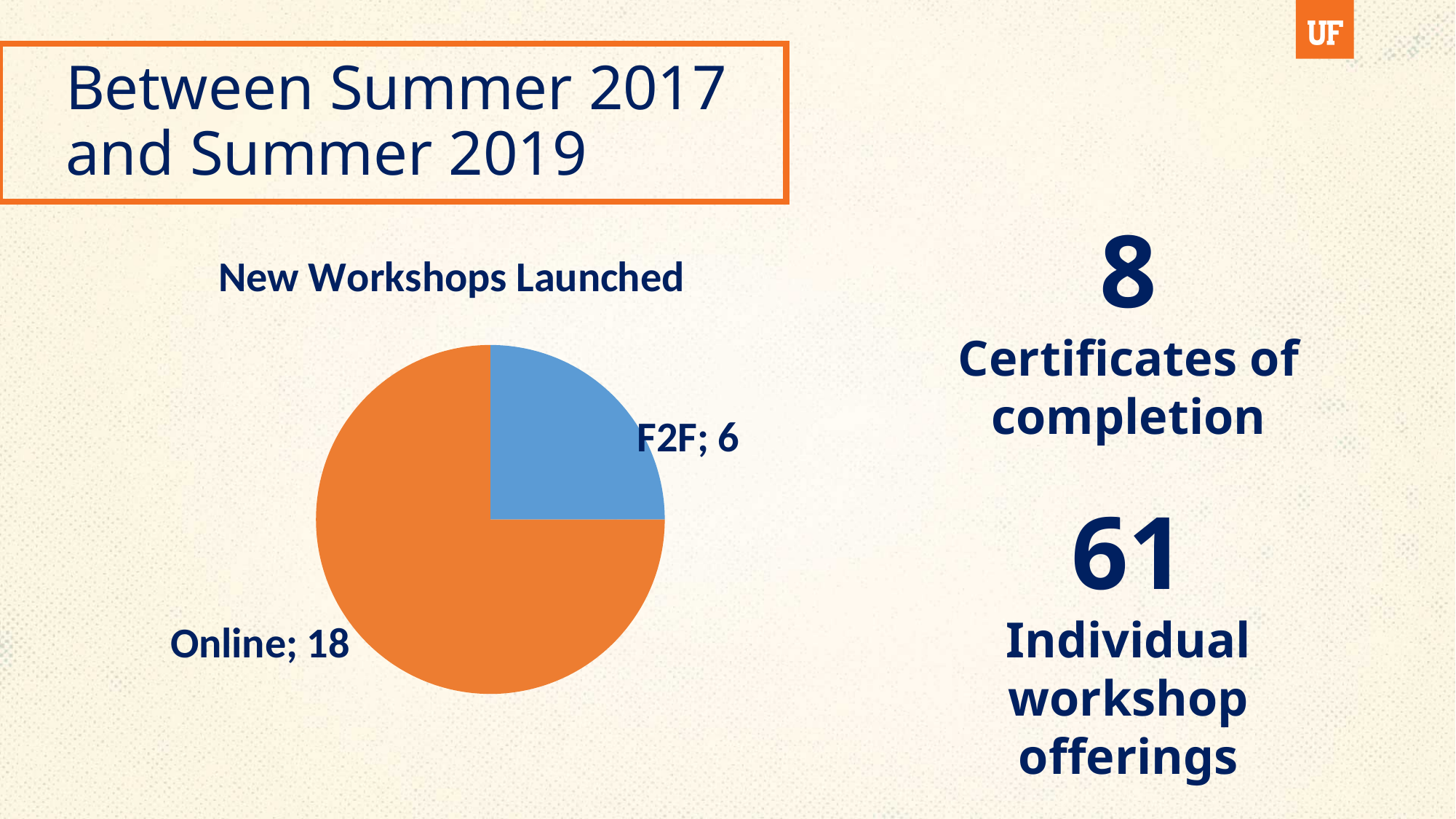
What is the title of the pie chart on the slide? New Workshops Launched Which is larger in the New Workshops Launched chart, Online or F2F? Online What share of the New Workshops Launched pie does the Online slice represent? 75% What kind of chart is the New Workshops Launched chart? Pie chart What is the difference between the Online and F2F values in the New Workshops Launched chart? 12 What is the value for F2F in the New Workshops Launched chart? 6 What is the total of all slices in the New Workshops Launched chart? 24 What is the value for Online in the New Workshops Launched chart? 18 What share of the New Workshops Launched pie does the F2F slice represent? 25% Which category has the smallest slice in the New Workshops Launched chart? F2F Which category has the largest slice in the New Workshops Launched chart? Online How many categories are shown in the New Workshops Launched chart? 2